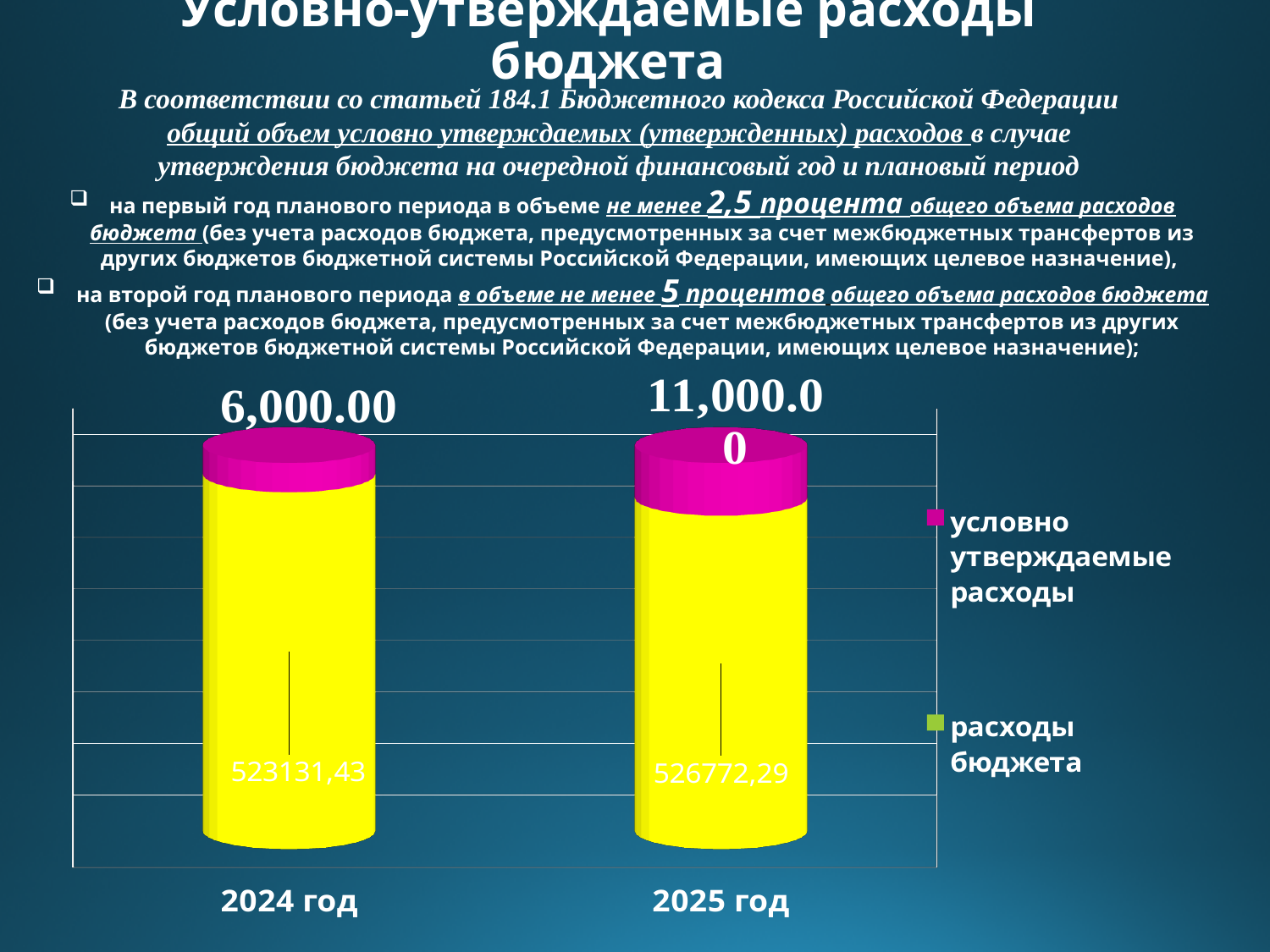
What is the difference between расходы бюджета in 2025 год and 2024 год? 3640,86 What is the value of условно утверждаемые расходы for 2025 год? 11,000.00 What is the value of расходы бюджета for 2025 год? 526772,29 Is расходы бюджета larger in 2024 год or 2025 год? 2025 год What is the value of условно утверждаемые расходы for 2024 год? 6,000.00 What kind of chart is shown on the slide? Stacked bar chart What is the value of расходы бюджета for 2024 год? 523131,43 Which year has the lower value of расходы бюджета? 2024 год How many categories (years) are shown on the x axis of the chart? 2 Which year has the higher value of условно утверждаемые расходы? 2025 год What is the difference between условно утверждаемые расходы in 2025 год and 2024 год? 5,000.00 How many series does the chart legend list? 2